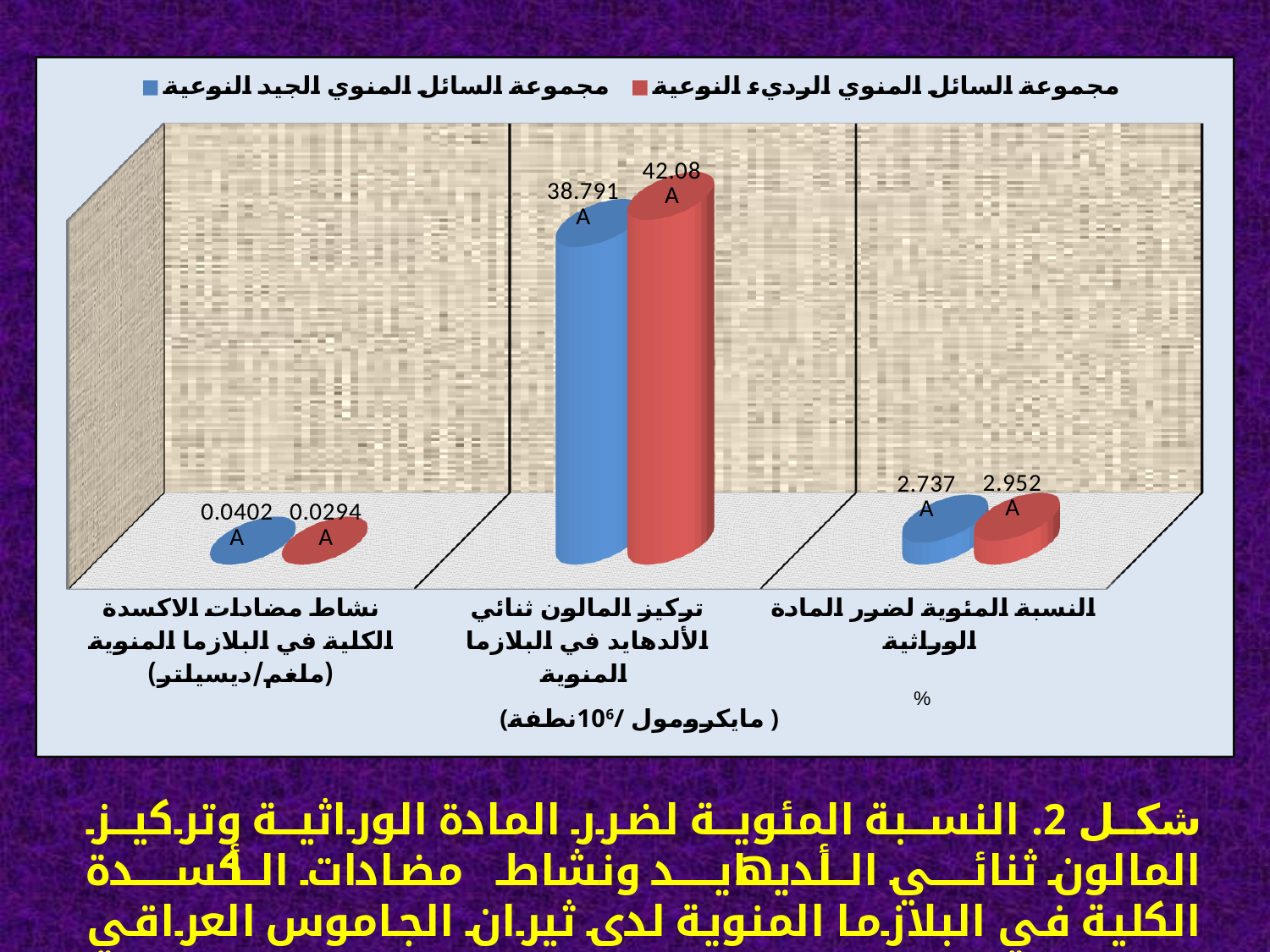
What is the difference between the poor-quality and good-quality group values in the category 'تركيز المالون ثنائي الألدهايد في البلازما المنوية'? 3.289 What is the value for the good-quality semen group in the category 'النسبة المئوية لضرر المادة الوراثية'? 2.737 What is the value for the poor-quality semen group (مجموعة السائل المنوي الرديء النوعية) in the category 'تركيز المالون ثنائي الألدهايد في البلازما المنوية'? 42.08 What is the value for the good-quality semen group in the category 'نشاط مضادات الاكسدة الكلية في البلازما المنوية'? 0.0402 What is the value for the poor-quality semen group in the category 'نشاط مضادات الاكسدة الكلية في البلازما المنوية'? 0.0294 What is the value for the poor-quality semen group in the category 'النسبة المئوية لضرر المادة الوراثية'? 2.952 What type of chart is shown on the slide? bar chart Which category has the highest values for both groups? تركيز المالون ثنائي الألدهايد في البلازما المنوية How many series does the legend list? 2 What is the value for the good-quality semen group (مجموعة السائل المنوي الجيد النوعية) in the category 'تركيز المالون ثنائي الألدهايد في البلازما المنوية'? 38.791 How many categories are shown on the x axis? 3 Which colour represents the poor-quality semen group (مجموعة السائل المنوي الرديء النوعية) in the legend? red